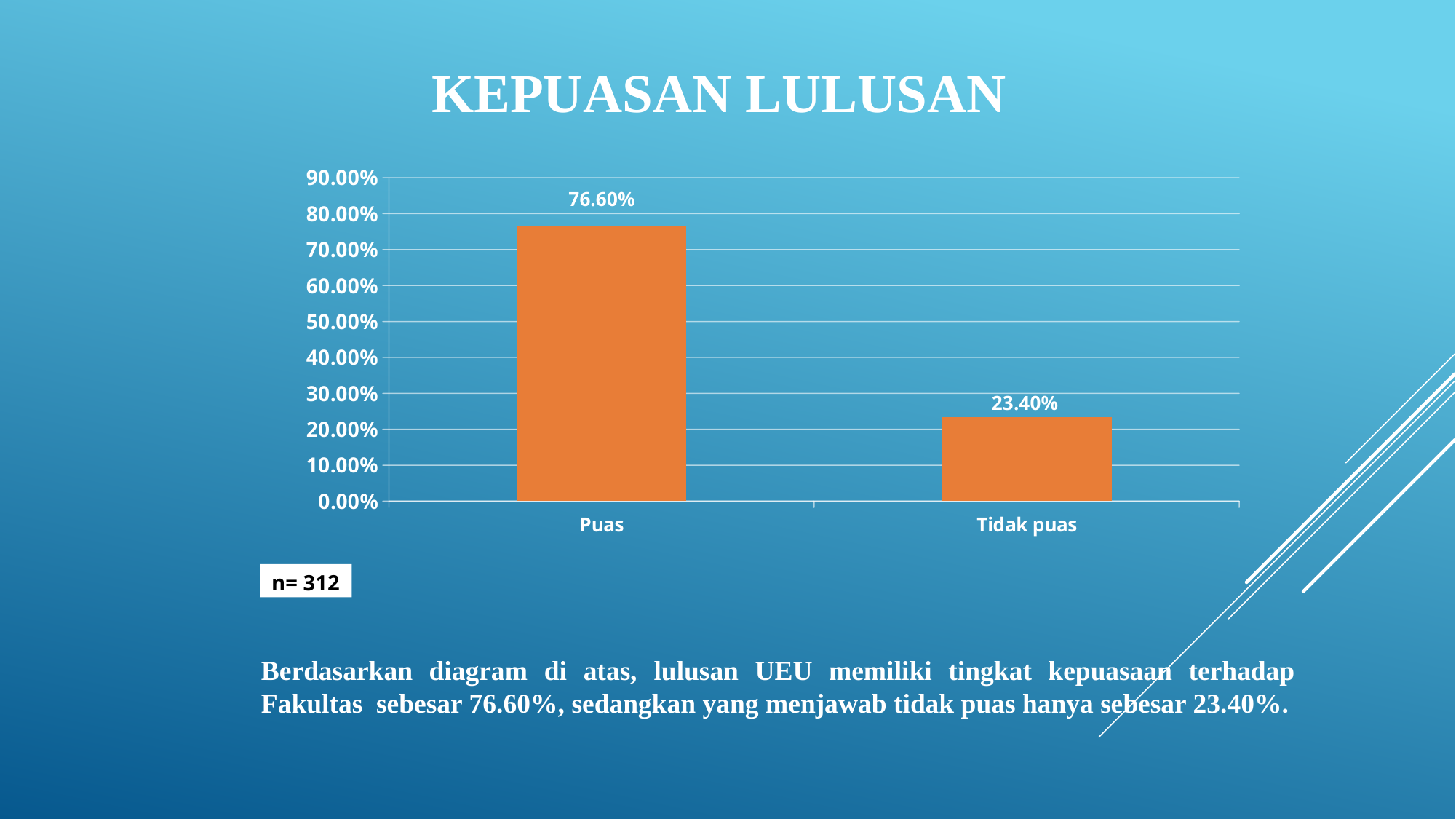
What is the title of the slide above the chart? KEPUASAN LULUSAN What is the difference between the values for Puas and Tidak puas? 53.20% How many categories are shown on the x axis? 2 What is the value for Puas? 76.60% What is the value for Tidak puas? 23.40% Which category has the lowest value? Tidak puas Which is larger, the value for Puas or the value for Tidak puas? Puas What kind of chart is shown on the slide? bar chart Which category has the highest value? Puas Is the value for Tidak puas greater or less than 30.00%? less Is the value for Puas greater or less than 70.00%? greater What is the sample size (n) shown below the chart? n= 312